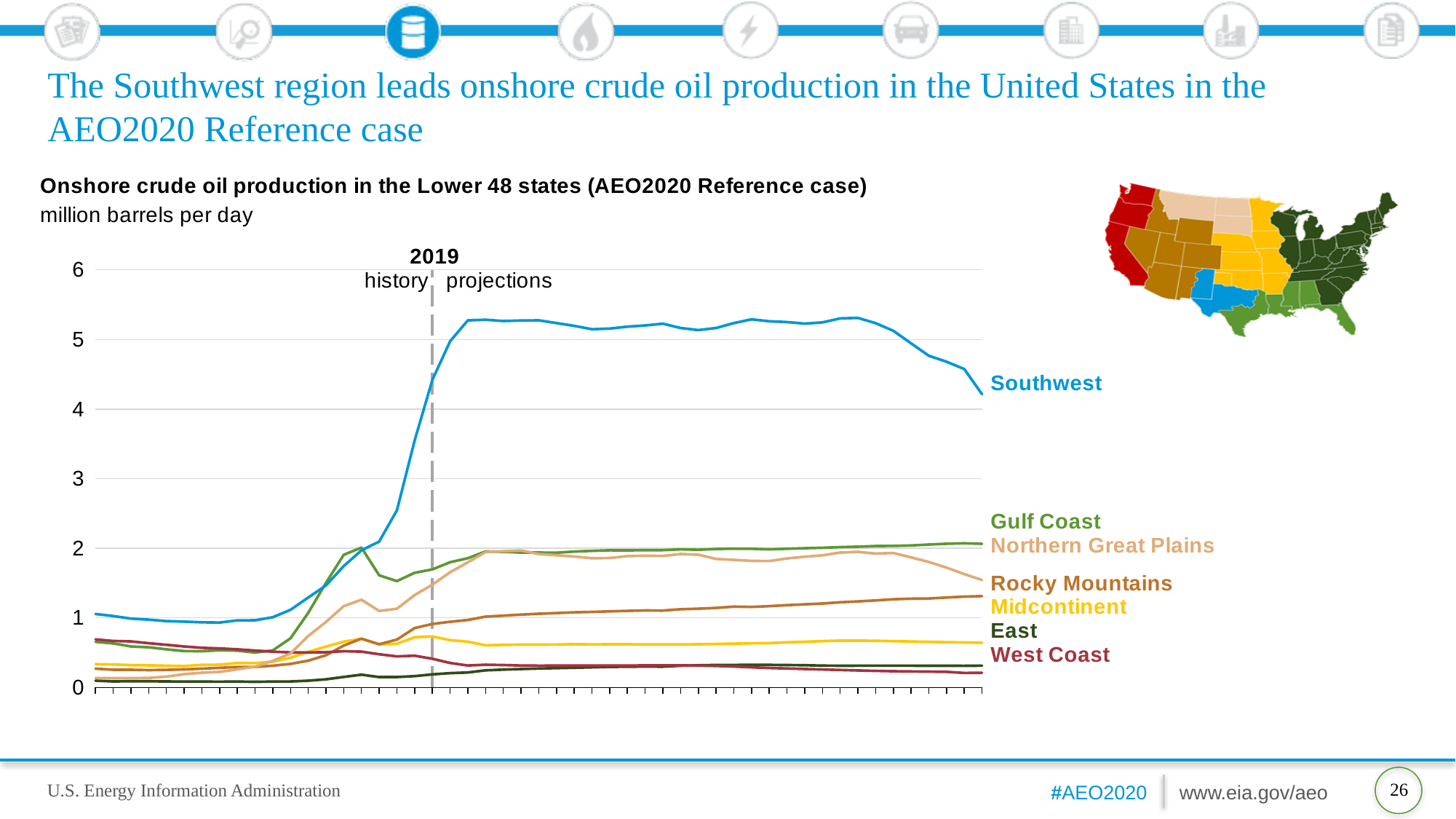
How many regions (series) are plotted in the chart? 7 At the right end of the chart, which is larger: Southwest or Gulf Coast? Southwest Is the peak value of the Southwest line greater or less than 5 million barrels per day? greater Is the Midcontinent line ever greater or less than 1 million barrels per day across the chart? less Does the Southwest line rise or fall over the last few years of the projection period? fall At the right end of the chart, is the Gulf Coast value greater or less than 1? greater Which region has the highest onshore crude oil production in the projection period? Southwest What unit is used on the chart's y axis? million barrels per day What kind of chart is shown on the slide? line chart At the right end of the chart, which is larger: Rocky Mountains or Midcontinent? Rocky Mountains What year does the dashed vertical line separating history from projections mark? 2019